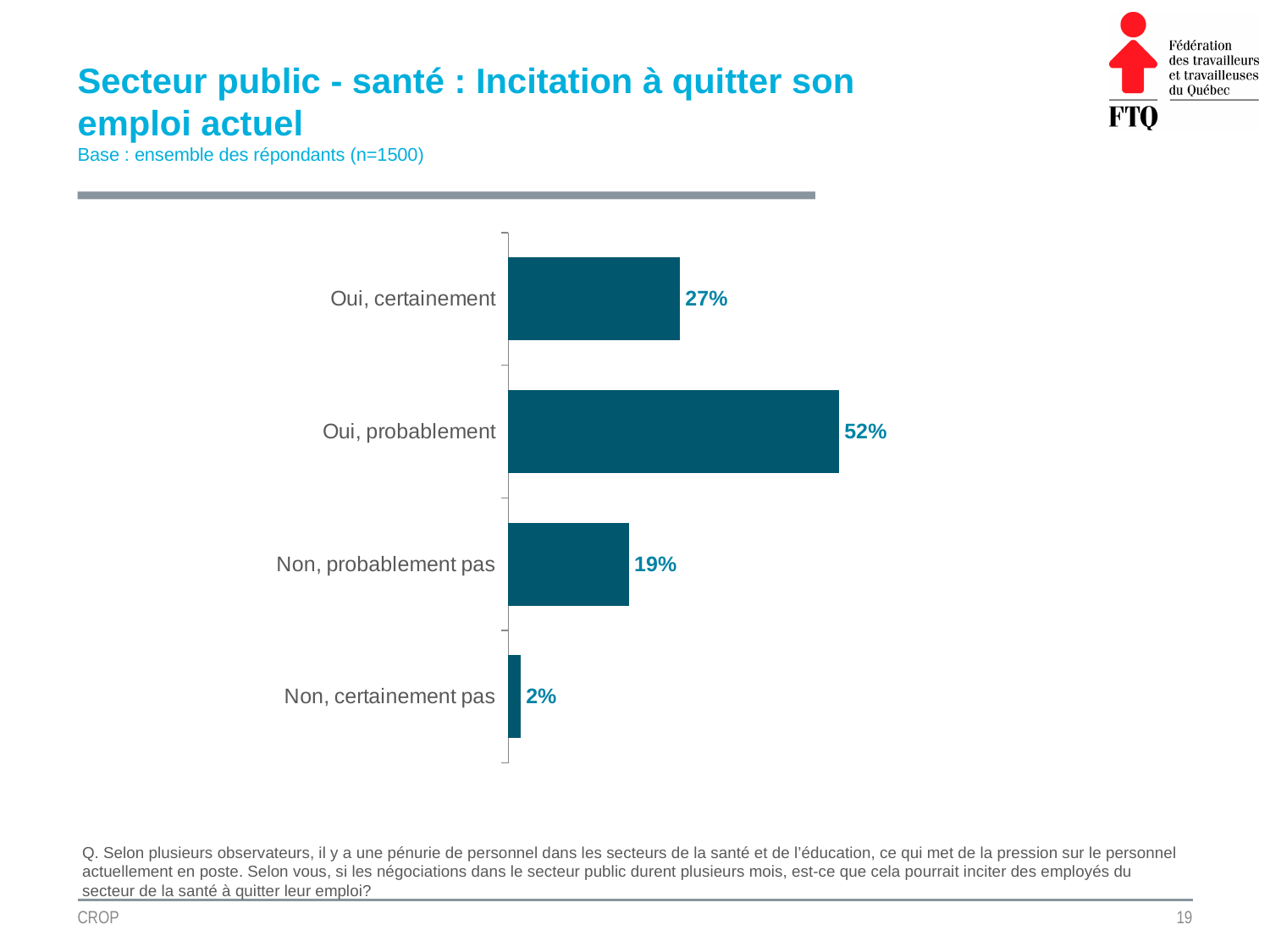
What is the difference between "Oui, certainement" and "Non, probablement pas"? 8% What is the value for "Oui, certainement"? 27% What is the value for "Non, probablement pas"? 19% Which is larger, "Oui, certainement" or "Non, probablement pas"? Oui, certainement What is the value for "Oui, probablement"? 52% Which category has the lowest value? Non, certainement pas Which category has the highest value? Oui, probablement What kind of chart is shown on the slide? Bar chart How many categories are shown in the chart? 4 What is the difference between "Oui, probablement" and "Oui, certainement"? 25% What is the combined value of "Oui, certainement" and "Oui, probablement"? 79% What is the value for "Non, certainement pas"? 2%